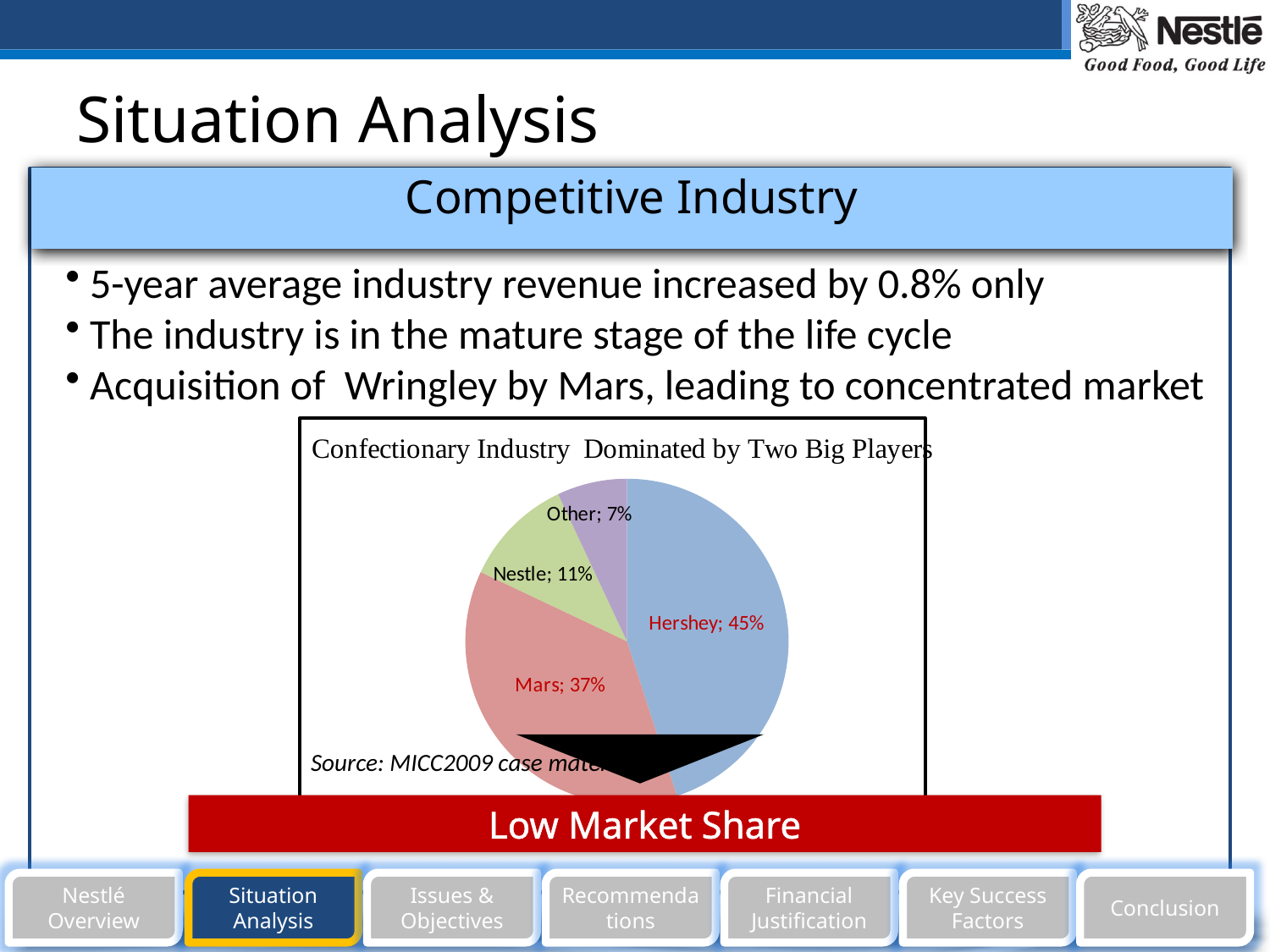
Which slice of the pie is the smallest? Other Which is larger, Nestle's share or Other's share? Nestle What type of chart is shown on the slide? pie chart How many slices does the pie chart have? 4 What is the market share for Mars? 37% What is the market share for Other? 7% What is the market share for Hershey? 45% What is the difference between Mars's and Nestle's market share? 26% What is the title of the pie chart? Confectionary Industry Dominated by Two Big Players Which company has the largest slice of the pie? Hershey What is the difference between Hershey's and Mars's market share? 8% What is the market share for Nestle? 11%